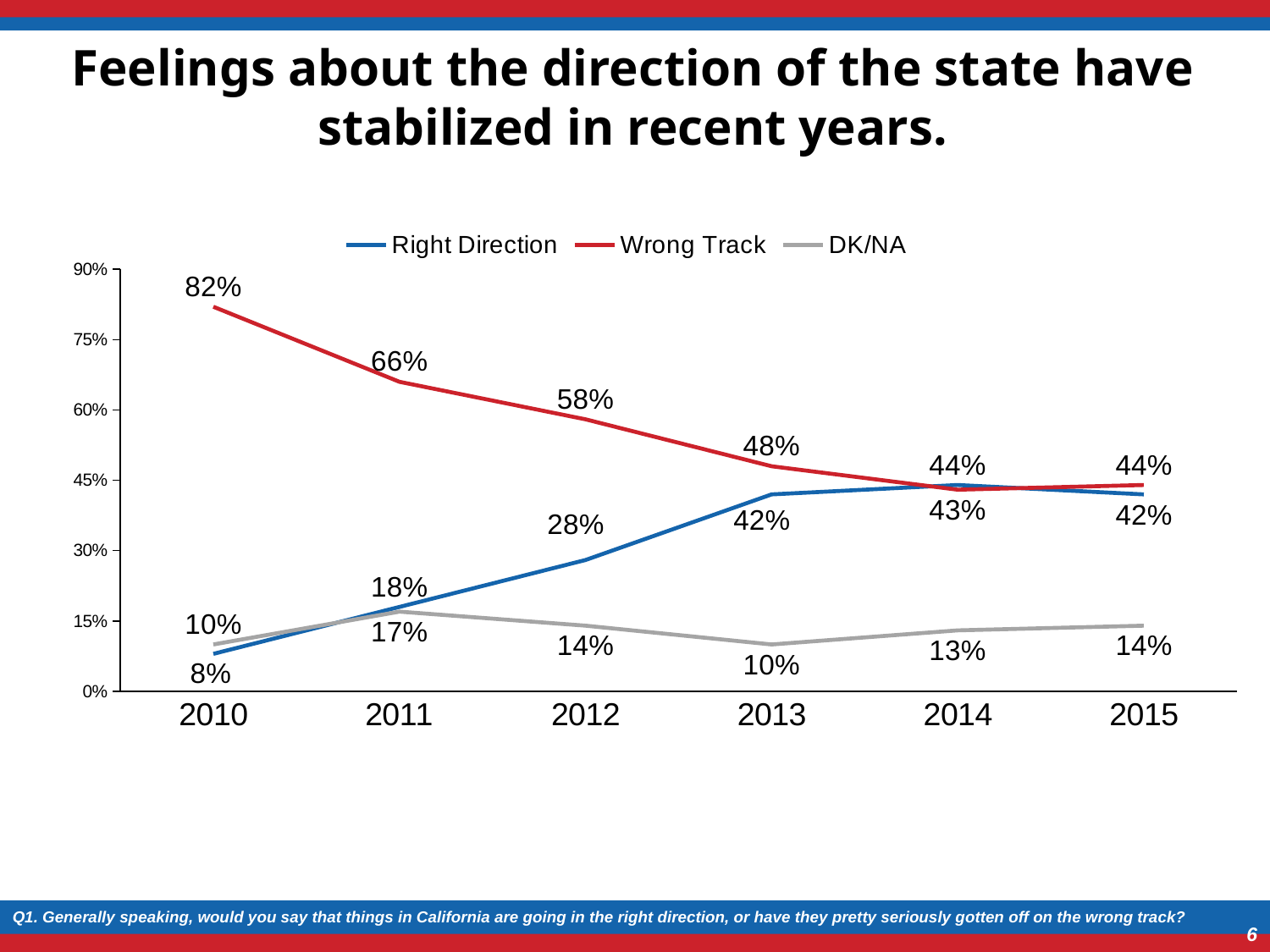
What kind of chart is shown on the slide? Line chart Does the Wrong Track line rise or fall from 2010 to 2013? Fall What is the Right Direction value in 2013? 42% How many years are plotted along the x axis? 6 By how many percentage points did Wrong Track fall from 2010 to 2013? 34 percentage points How many series does the legend list? 3 In which year is the Wrong Track value highest? 2010 In which year is the Right Direction value lowest? 2010 What is the Wrong Track value in 2010? 82% What is the Right Direction value in 2015? 42% In 2012, which is larger: Wrong Track or Right Direction? Wrong Track What is the DK/NA value in 2011? 17%